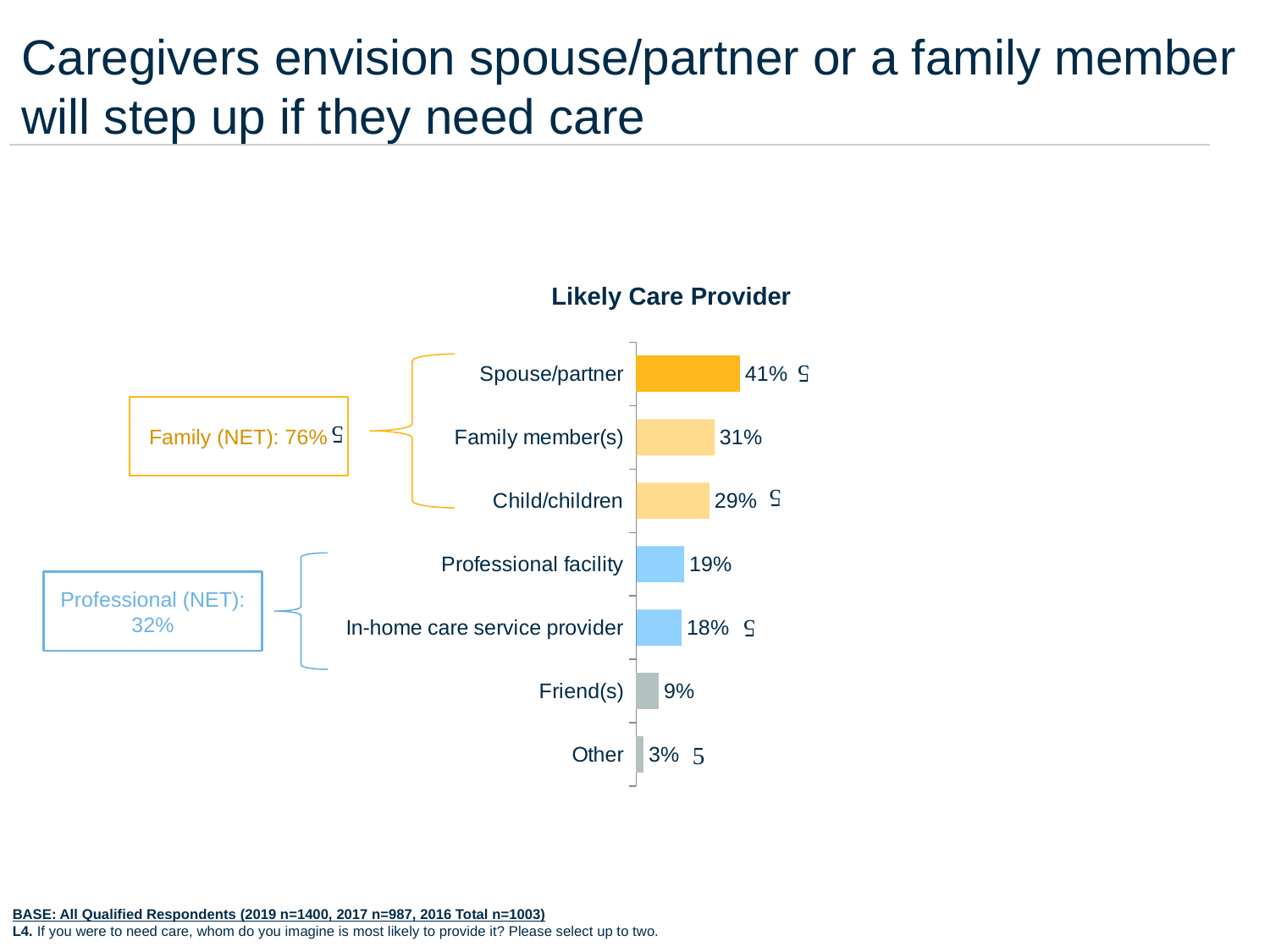
What kind of chart is shown on the slide? Bar chart How many categories are shown in the chart? 7 What is the difference between the values for Spouse/partner and Family member(s)? 10% What is the value for In-home care service provider? 18% What is the value for Child/children? 29% Which category has the lowest value? Other Which is larger, the value for Professional facility or the value for Friend(s)? Professional facility Which category has the highest value? Spouse/partner What is the Family (NET) value shown in the box next to the chart? 76% What is the value for Friend(s)? 9% What is the value for Spouse/partner? 41% What is the title of the chart? Likely Care Provider